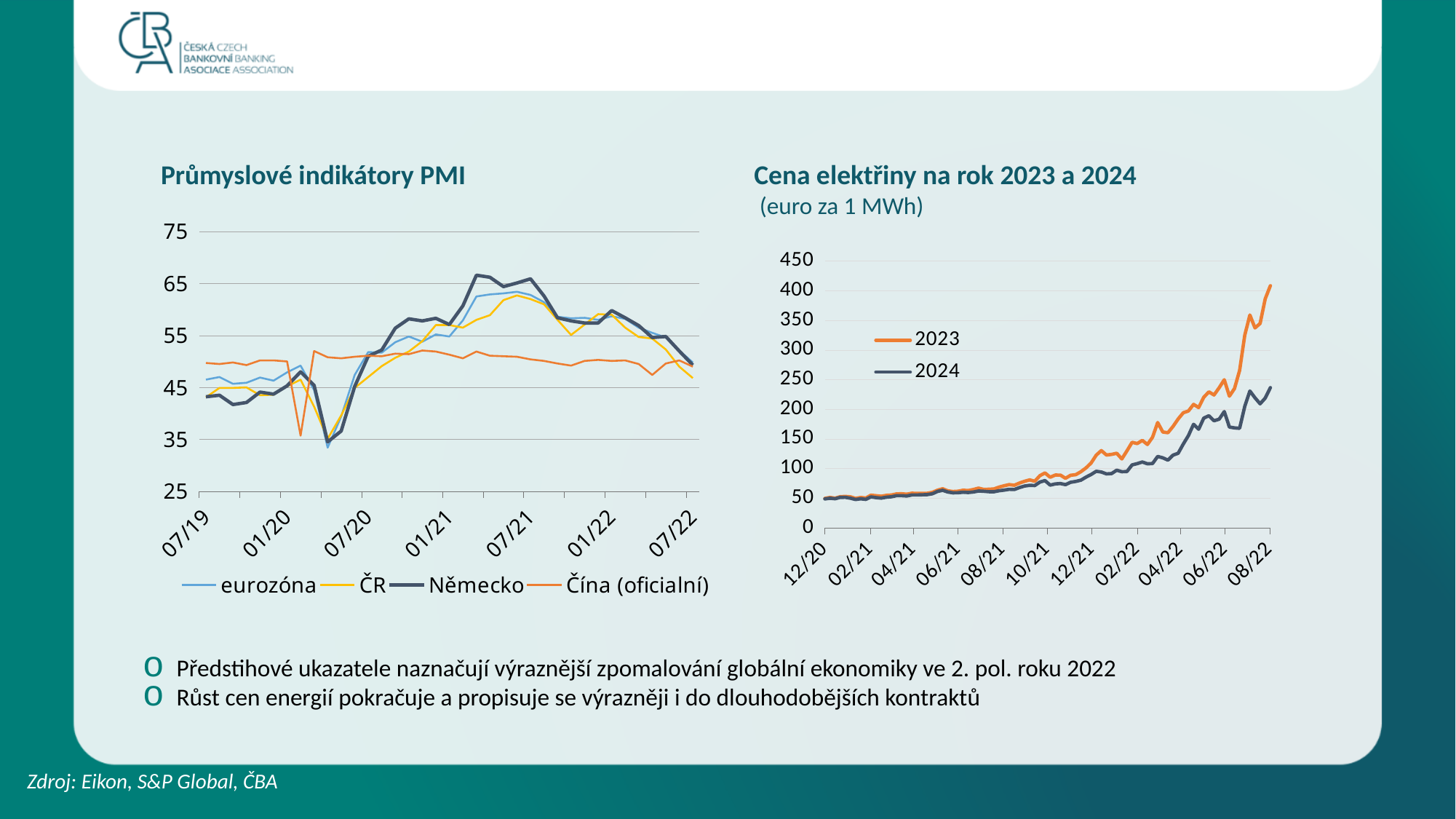
In the 'Cena elektřiny na rok 2023 a 2024' chart, do the values generally rise or fall from 12/20 to 08/22? rise In the 'Cena elektřiny na rok 2023 a 2024' chart, is the value of the 2023 series at 08/22 greater or less than 350? greater What unit is given in the subtitle of the 'Cena elektřiny na rok 2023 a 2024' chart? euro za 1 MWh In the 'Cena elektřiny na rok 2023 a 2024' chart, which series is higher at 08/22, 2023 or 2024? 2023 How many series does the legend of the 'Cena elektřiny na rok 2023 a 2024' chart list? 2 How many series does the legend of the 'Průmyslové indikátory PMI' chart list? 4 In the 'Cena elektřiny na rok 2023 a 2024' chart, is the value of the 2024 series at 08/22 greater or less than 250? less In the 'Průmyslové indikátory PMI' chart, which series are listed in the legend? eurozóna, ČR, Německo, Čína (oficialní) What kind of chart is the 'Cena elektřiny na rok 2023 a 2024' chart? line chart In the 'Průmyslové indikátory PMI' chart, is the value of Německo at 07/21 greater or less than 55? greater What kind of chart is the 'Průmyslové indikátory PMI' chart? line chart